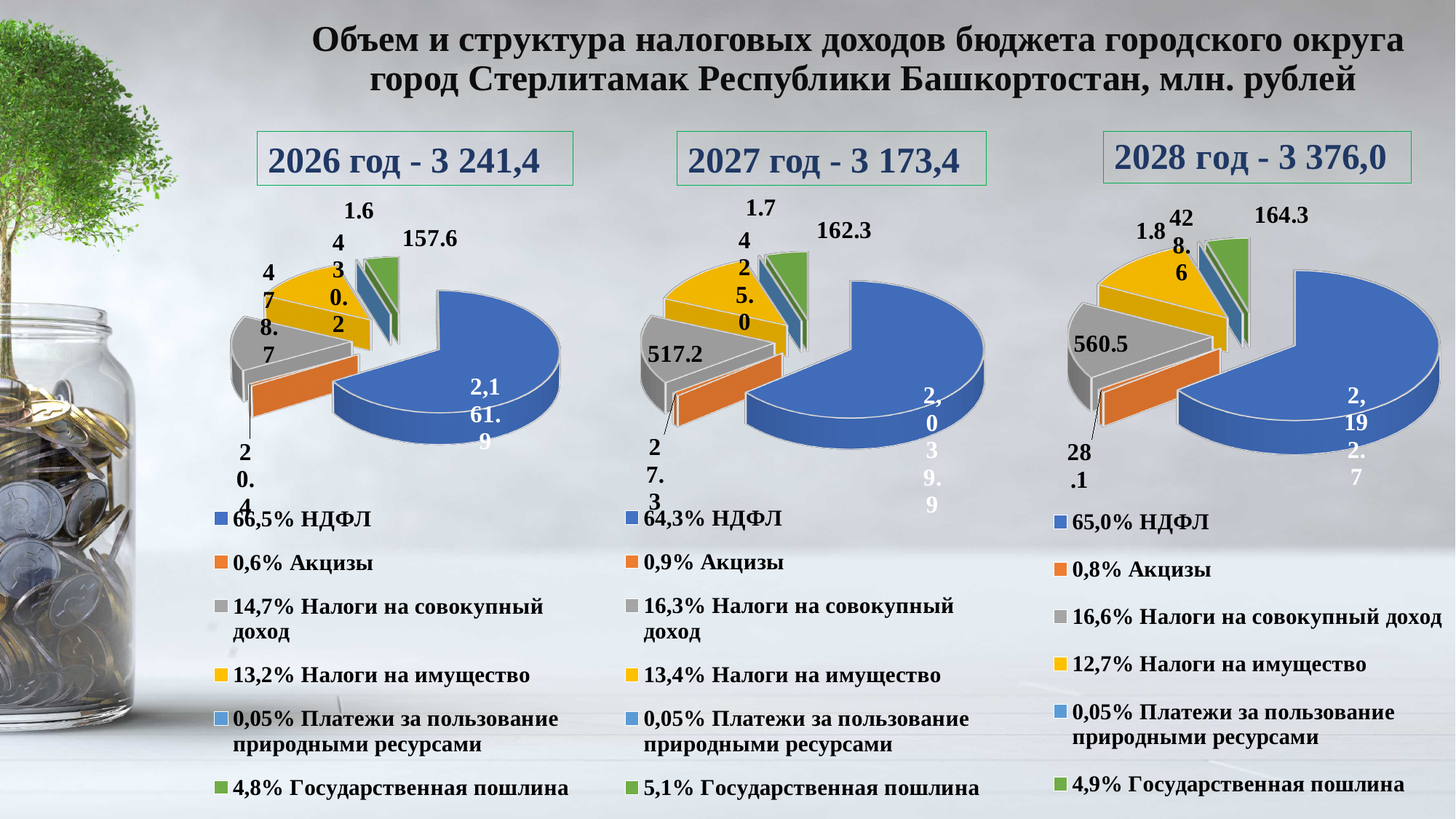
In the 2028 год pie chart, what is the value for Налоги на совокупный доход? 560.5 What share of the 2026 год pie does Налоги на имущество account for, according to the legend? 13,2% In the 2026 год pie chart, what is the value for Государственная пошлина? 157.6 How many categories does the legend of the 2027 год pie chart list? 6 In the 2027 год pie chart, which category has the largest slice? НДФЛ In the 2028 год pie chart, what is the value for Платежи за пользование природными ресурсами? 1.8 What is the difference between the Налоги на совокупный доход values in the 2028 год and 2027 год pie charts? 43.3 Which is larger: Государственная пошлина in the 2027 год chart or in the 2026 год chart? 2027 год (162.3) What share of the 2028 год pie does НДФЛ account for, according to the legend? 65,0% In the 2026 год pie chart, which category has the smallest slice? Платежи за пользование природными ресурсами What type of chart is used for the 2026 год data on the slide? Pie chart In the 2027 год pie chart, what is the value for Налоги на совокупный доход? 517.2